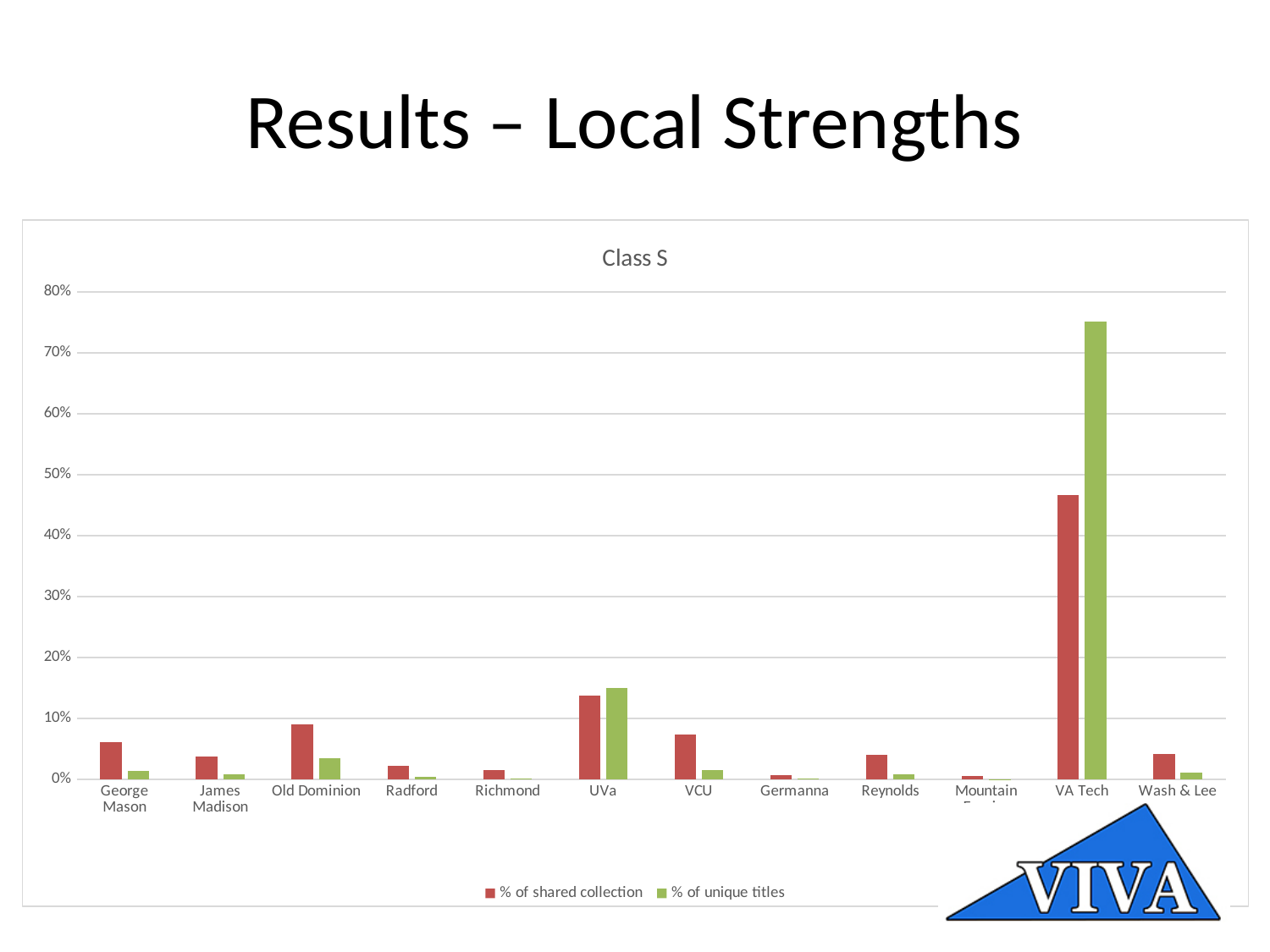
Which is larger for UVa: the % of shared collection or the % of unique titles? % of unique titles What kind of chart is shown on the slide? bar chart Is the % of unique titles for VA Tech greater or less than 70%? greater Which institution has a larger % of shared collection, Old Dominion or George Mason? Old Dominion Which colour represents the % of unique titles series? green Is the % of unique titles for UVa greater or less than 10%? greater How many series does the legend list? 2 How many institutions (categories) are shown on the x axis? 12 Which institution has the highest % of shared collection? VA Tech Is the % of shared collection for VA Tech greater or less than 50%? less Which institution has the highest % of unique titles? VA Tech What is the title of the chart? Class S